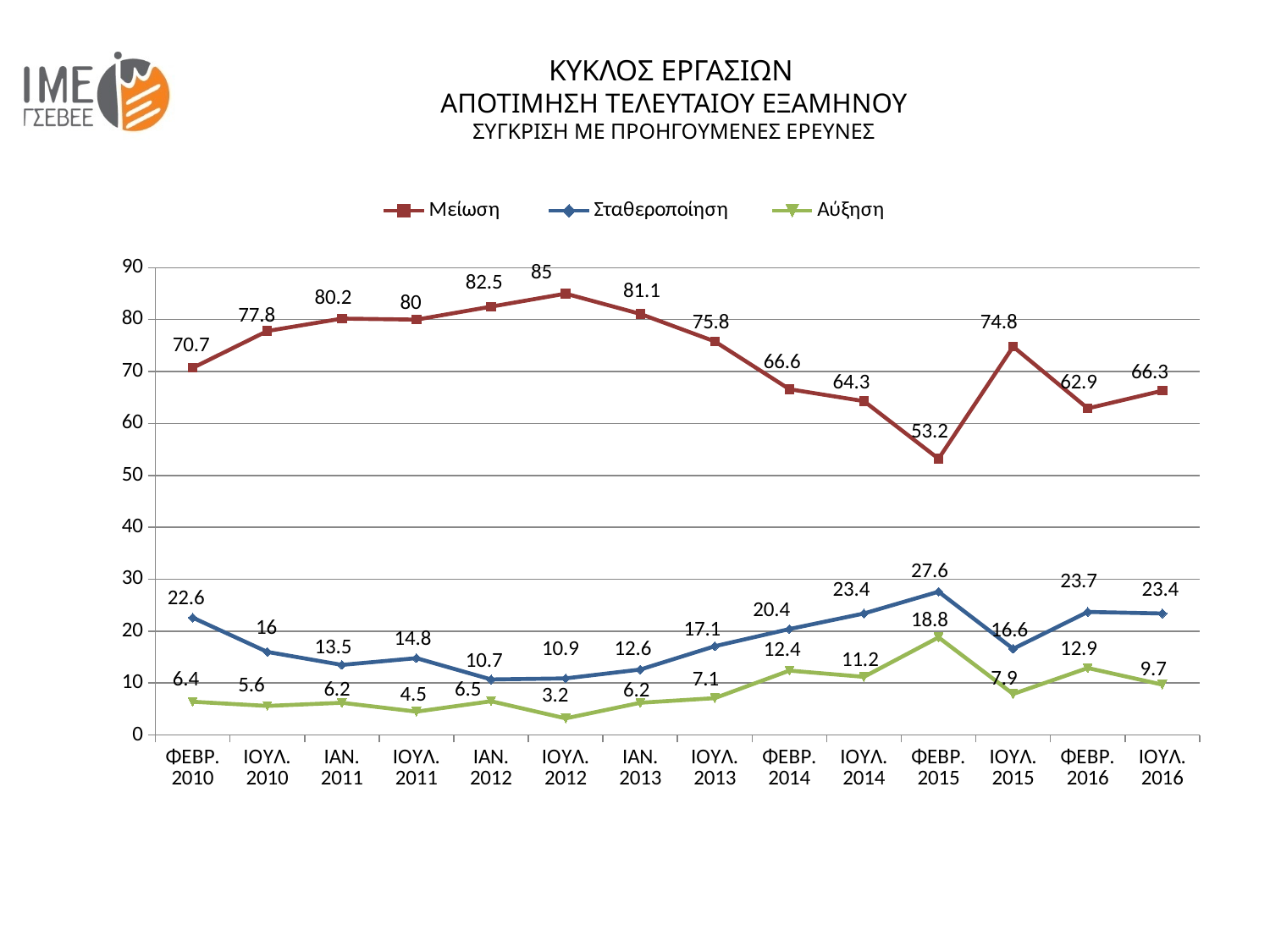
What is the difference between Μείωση at ΦΕΒΡ. 2015 and at ΙΟΥΛ. 2015? 21.6 What is the value of Σταθεροποίηση for ΦΕΒΡ. 2015? 27.6 Which series is drawn in green? Αύξηση At which survey date is Αύξηση highest? ΦΕΒΡ. 2015 What is the value of Μείωση for ΙΟΥΛ. 2012? 85 What kind of chart is shown on the slide? Line chart How many series does the legend list? 3 Does Μείωση rise or fall from ΙΟΥΛ. 2012 to ΦΕΒΡ. 2015? Fall What is the value of Αύξηση for ΙΟΥΛ. 2016? 9.7 How many survey dates are shown on the x axis? 14 Which is larger: Σταθεροποίηση at ΦΕΒΡ. 2010 or at ΙΟΥΛ. 2010? ΦΕΒΡ. 2010 At which survey date is Μείωση lowest? ΦΕΒΡ. 2015